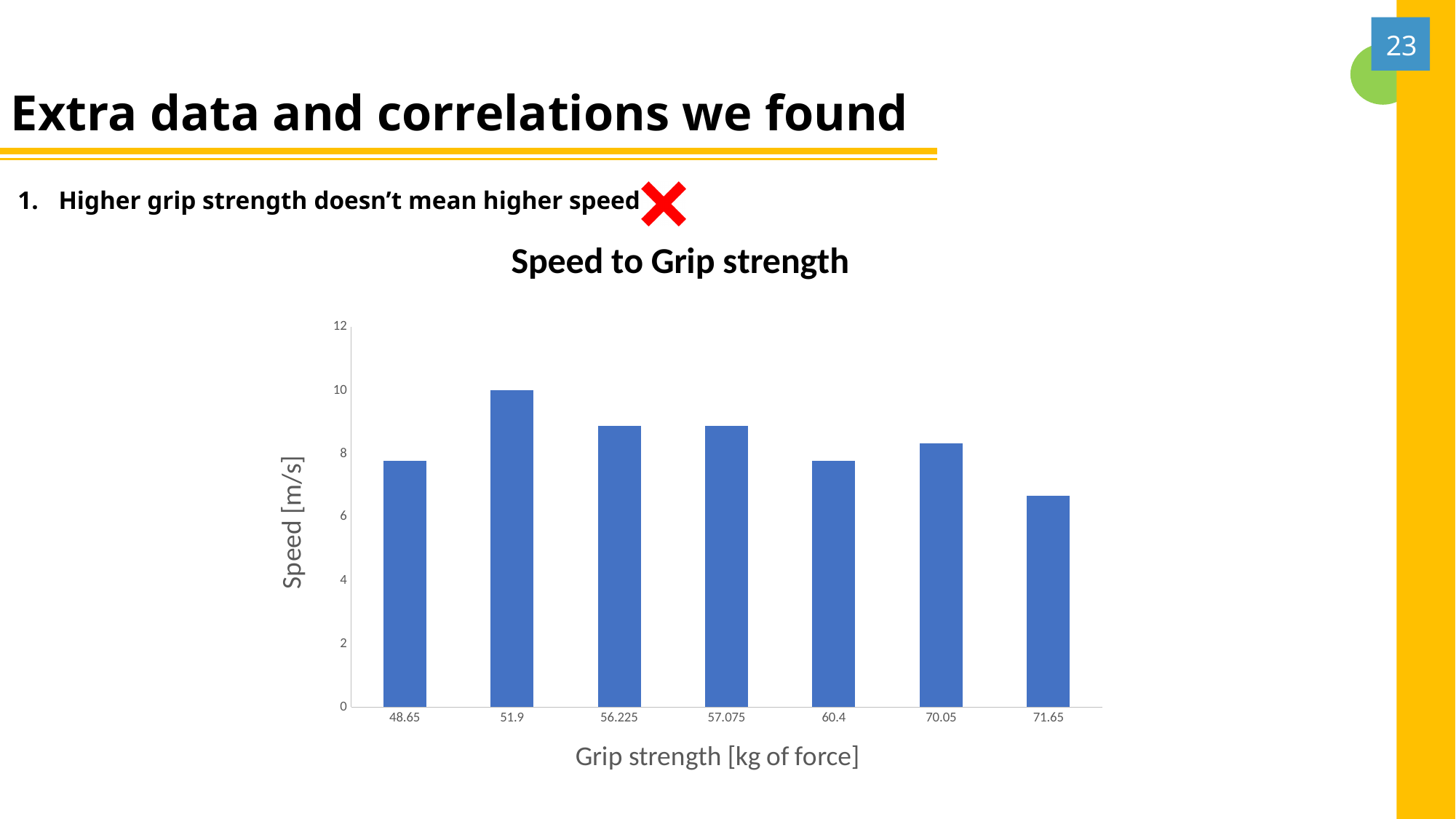
Is the speed for grip strength 56.225 greater or less than 10? less Is the speed for grip strength 48.65 greater or less than 8? less Which grip strength category has the highest speed? 51.9 Which has the higher speed: grip strength 51.9 or grip strength 56.225? 51.9 What is the title of the chart? Speed to Grip strength Which grip strength category has the lowest speed? 71.65 What type of chart is shown on the slide? bar chart Which has the higher speed: grip strength 70.05 or grip strength 71.65? 70.05 How many bars are plotted in the chart? 7 What is the label of the vertical axis of the chart? Speed [m/s] Is the speed for grip strength 71.65 greater or less than 8? less